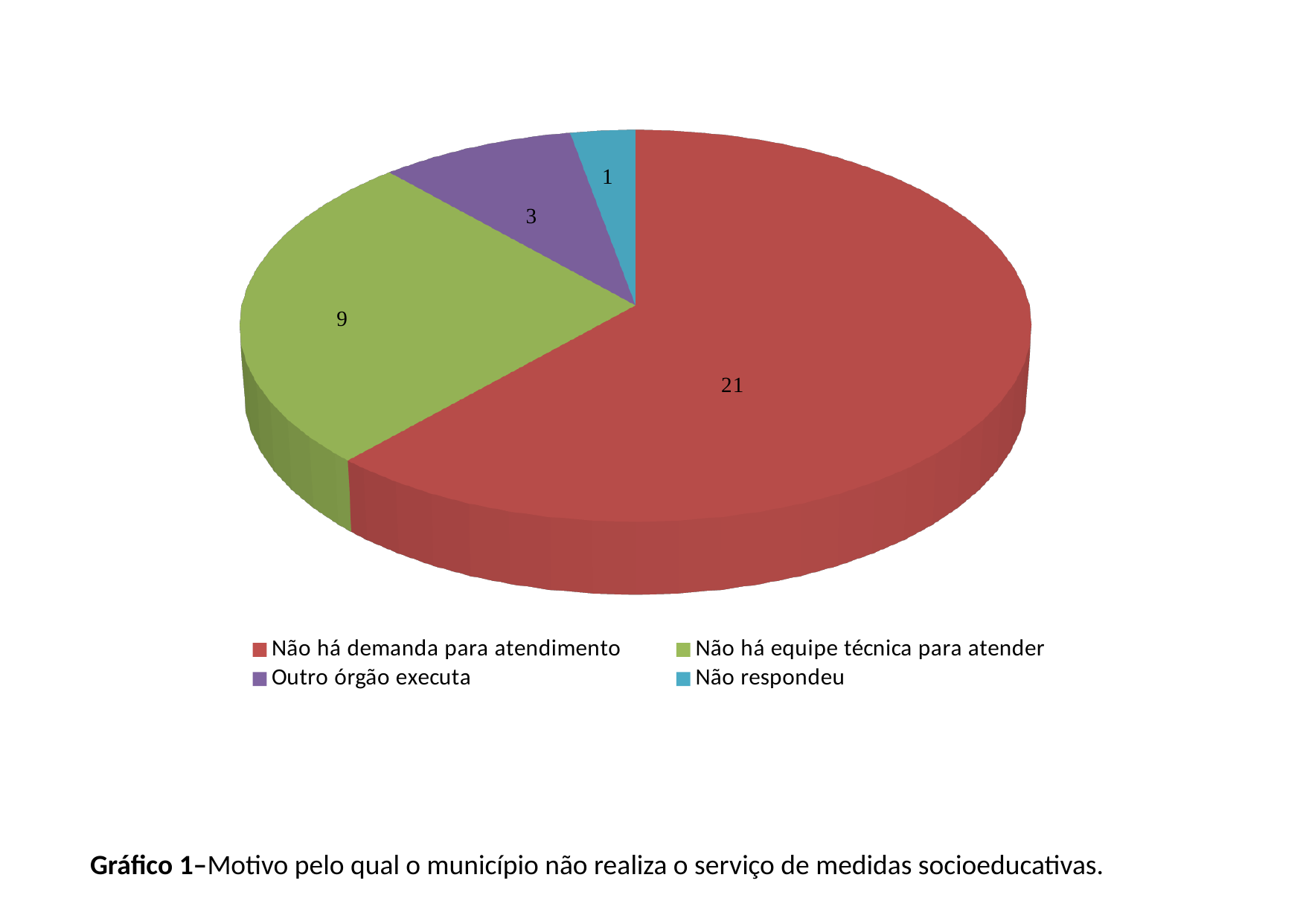
Which is larger, the value for "Outro órgão executa" or the value for "Não respondeu"? Outro órgão executa What is the value for "Não há equipe técnica para atender"? 9 What is the total of all the slices in the pie chart? 34 What is the value for "Não respondeu"? 1 What kind of chart is shown on the slide? Pie chart What is the difference between the values for "Não há demanda para atendimento" and "Não há equipe técnica para atender"? 12 What is the value for "Outro órgão executa"? 3 Which category has the largest slice of the pie? Não há demanda para atendimento What is the value for "Não há demanda para atendimento"? 21 How many categories does the pie chart have? 4 Which category has the smallest slice of the pie? Não respondeu What colour is the slice for "Não há equipe técnica para atender"? Green